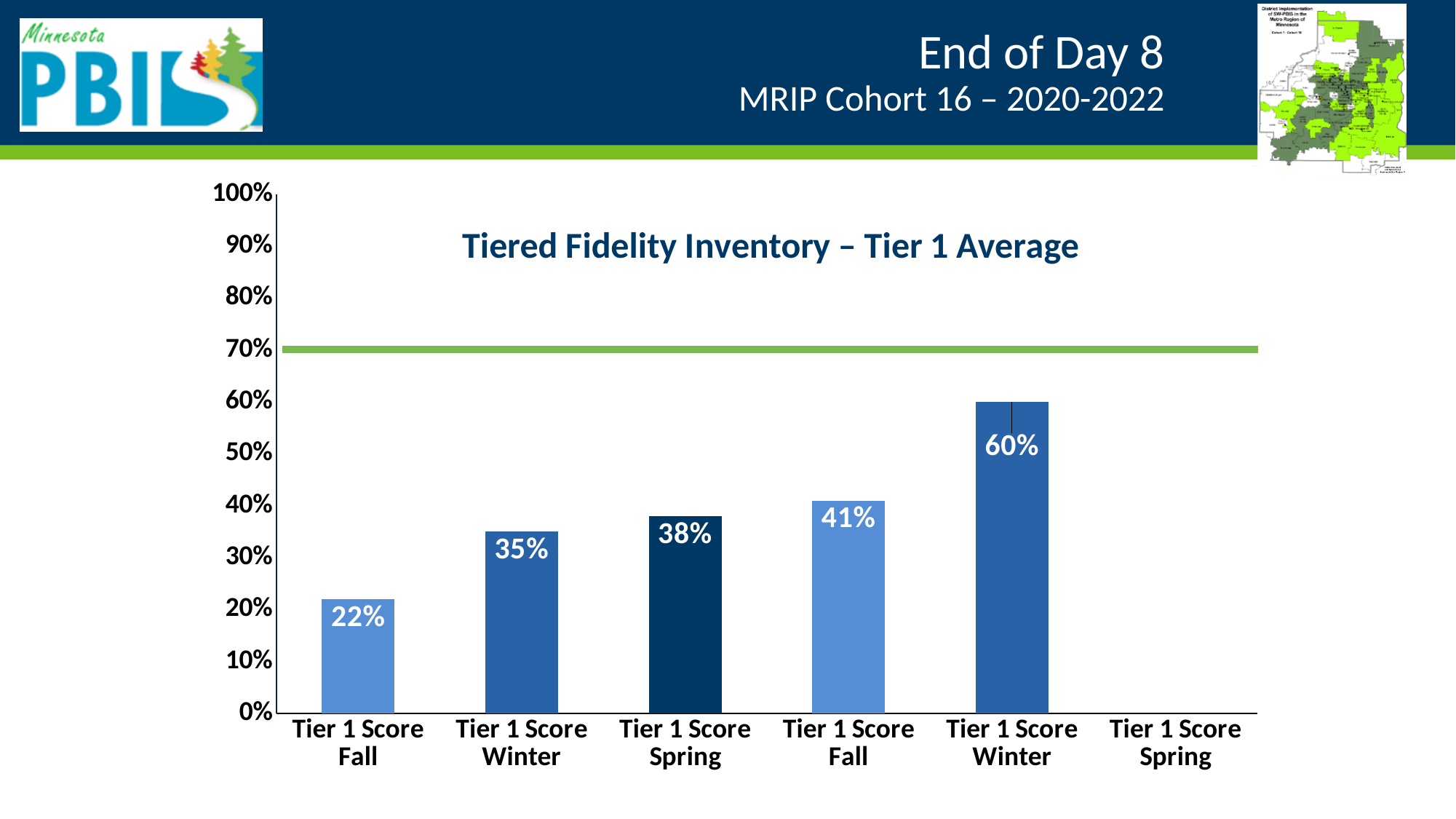
What is the value of the first Tier 1 Score Fall bar? 22% How many category labels are shown on the x axis? 6 What is the value of the Tier 1 Score Spring bar that has a data label? 38% What is the value of the second Tier 1 Score Fall bar? 41% Which is larger, the first Tier 1 Score Winter bar or the first Tier 1 Score Spring bar? The first Tier 1 Score Spring bar (38%) Which bar has the highest value? The second Tier 1 Score Winter bar (60%) What is the value of the first Tier 1 Score Winter bar? 35% What is the value of the second Tier 1 Score Winter bar? 60% At what value is the horizontal green line drawn on the chart? 70% Which labelled bar has the lowest value? The first Tier 1 Score Fall bar (22%) What is the difference between the second Tier 1 Score Winter bar and the second Tier 1 Score Fall bar? 19% What type of chart is shown on the slide? Bar chart